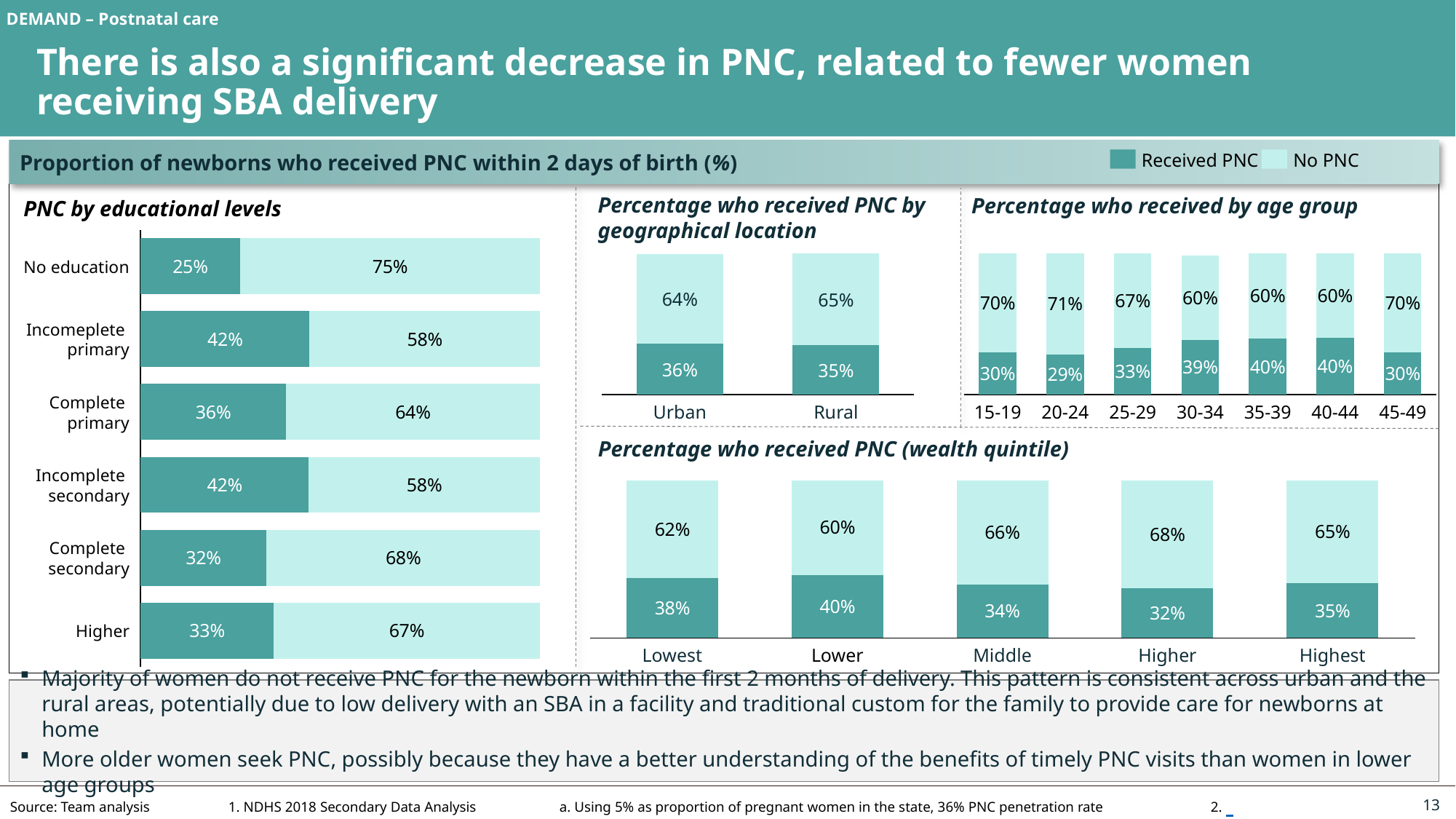
In the 'PNC by educational levels' chart, which educational level has the lowest 'Received PNC' value? No education In the 'Percentage who received by age group' chart, which age group has the lowest 'Received PNC' value? 20-24 In the 'Percentage who received PNC by geographical location' chart, what is the 'Received PNC' value for Urban? 36% In the 'Percentage who received PNC (wealth quintile)' chart, which wealth quintile has the highest 'Received PNC' value? Lower In the 'PNC by educational levels' chart, how many educational level categories are shown? 6 In the 'PNC by educational levels' chart, what percentage of newborns of mothers with no education received PNC? 25% In the 'Percentage who received PNC by geographical location' chart, what is the difference between the 'No PNC' values for Rural and Urban? 1% In the 'Percentage who received PNC (wealth quintile)' chart, is the 'Received PNC' value for Lowest larger or smaller than the value for Higher? larger How many series does the legend at the top of the slide list? 2 In the 'PNC by educational levels' chart, what is the 'No PNC' value for Complete secondary? 68% In the 'Percentage who received by age group' chart, how many age groups are shown? 7 In the 'Percentage who received by age group' chart, what is the 'Received PNC' value for 30-34? 39%